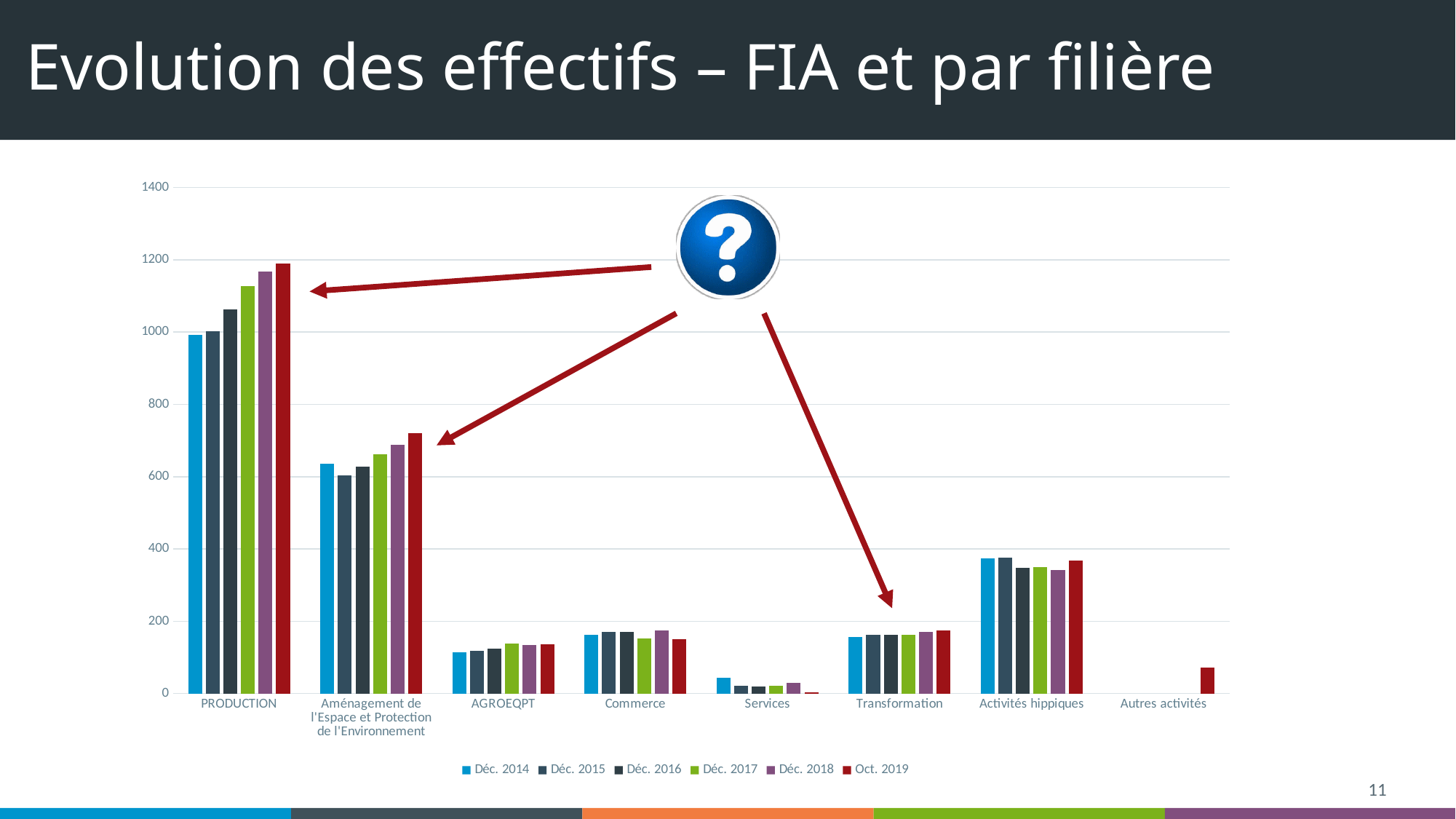
Which category has the highest values in the chart? PRODUCTION How many series does the chart's legend list? 6 Is the Oct. 2019 value for Aménagement de l'Espace et Protection de l'Environnement greater or less than 600? greater Which series is listed first in the chart's legend? Déc. 2014 Do the PRODUCTION values rise or fall from Déc. 2014 to Oct. 2019? rise Is the Déc. 2014 value for Activités hippiques greater or less than 400? less Which is larger in Déc. 2014: Commerce or AGROEQPT? Commerce Which category has the lowest Oct. 2019 value? Services Is the Oct. 2019 value for PRODUCTION greater or less than 1000? greater What kind of chart is shown on the slide? bar chart How many categories are shown along the x axis of the chart? 8